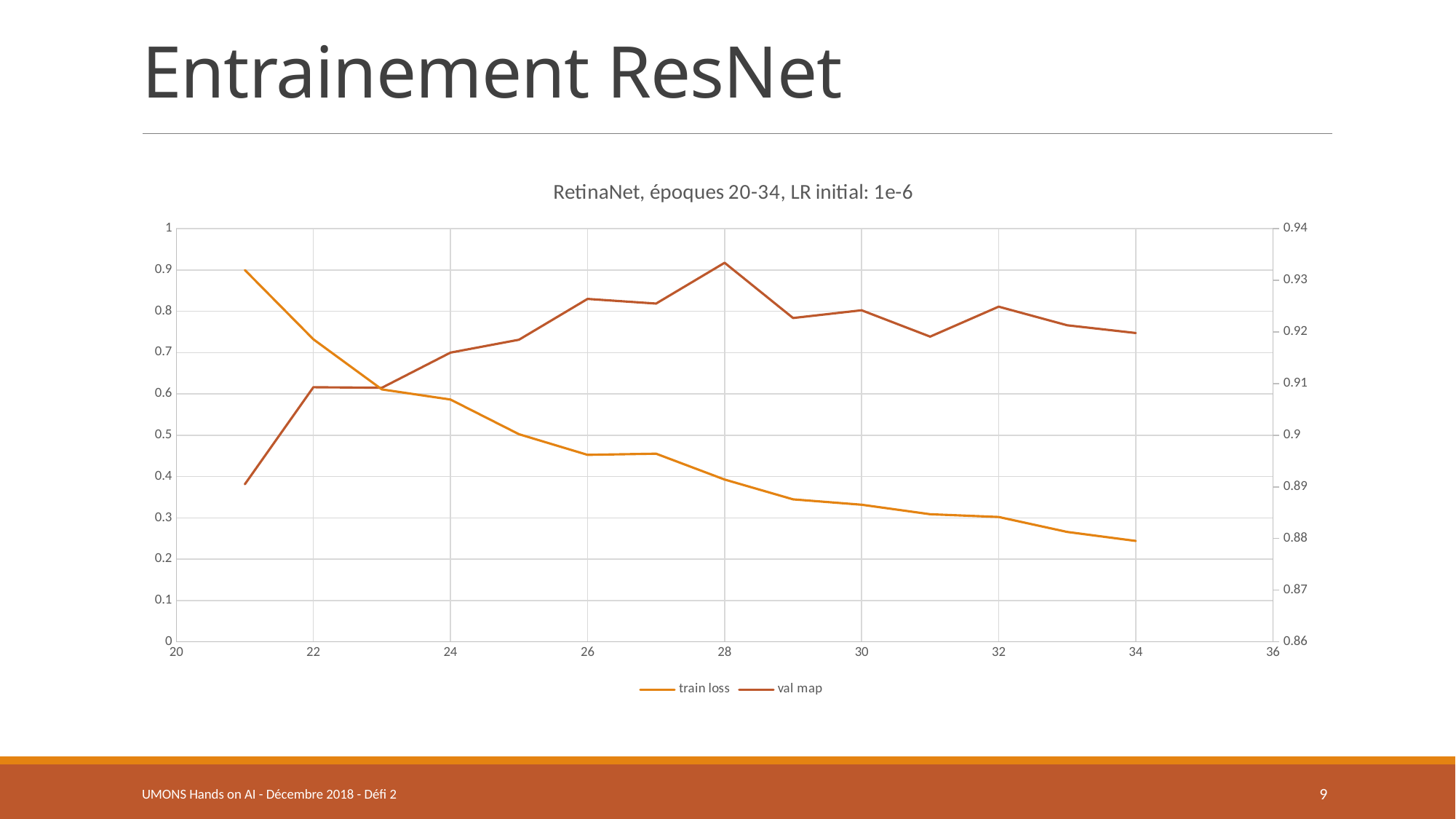
Is the train loss at epoch 34 greater or less than 0.3? less At which epoch is train loss lowest? 34 At which epoch is train loss highest? 21 What kind of chart is shown on the slide? line chart Which series is drawn in the darker red-brown colour? val map How many series does the legend list? 2 What is the title of the chart? RetinaNet, époques 20-34, LR initial: 1e-6 Is the train loss at epoch 21 greater or less than 0.8? greater How many data points does the train loss series have? 14 At which epoch is val map highest? 28 Is the val map at epoch 28 greater or less than 0.93? greater Does the train loss rise or fall as the epoch increases? fall